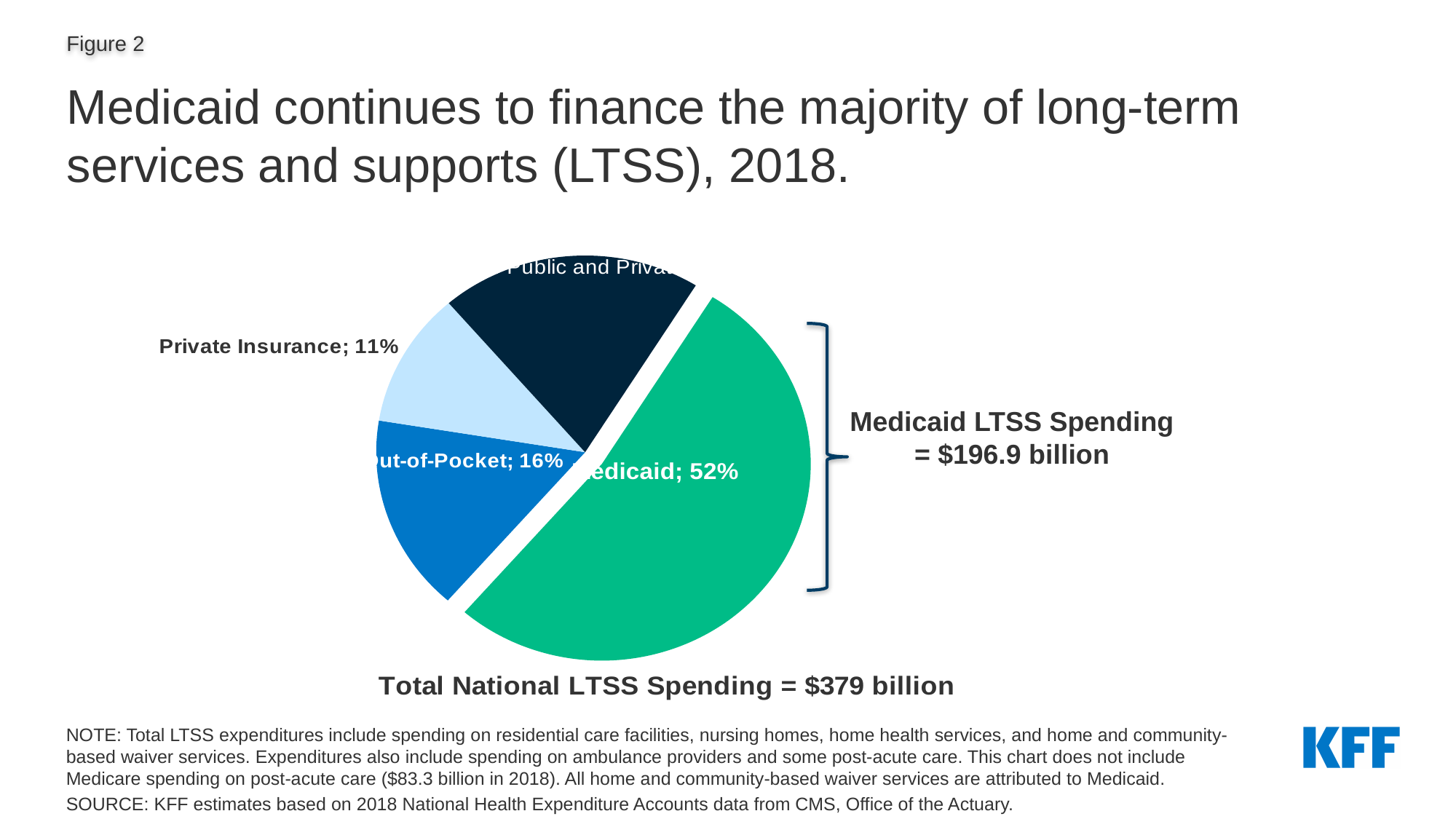
What is the total national LTSS spending shown below the chart? $379 billion How many percentage points larger is the Medicaid share than the Out-of-Pocket share? 36 percentage points What share of LTSS spending is Private Insurance? 11% How many slices does the pie chart have? 4 What share of LTSS spending does Medicaid account for? 52% How many percentage points larger is the Out-of-Pocket share than the Private Insurance share? 5 percentage points What is the Medicaid LTSS spending amount indicated by the bracket next to the chart? $196.9 billion What share of LTSS spending is Out-of-Pocket? 16% Which payer has the largest slice of the pie? Medicaid Which is larger, the Out-of-Pocket share or the Private Insurance share? Out-of-Pocket Which labeled payer has the smallest slice of the pie? Private Insurance What type of chart is shown on the slide? Pie chart